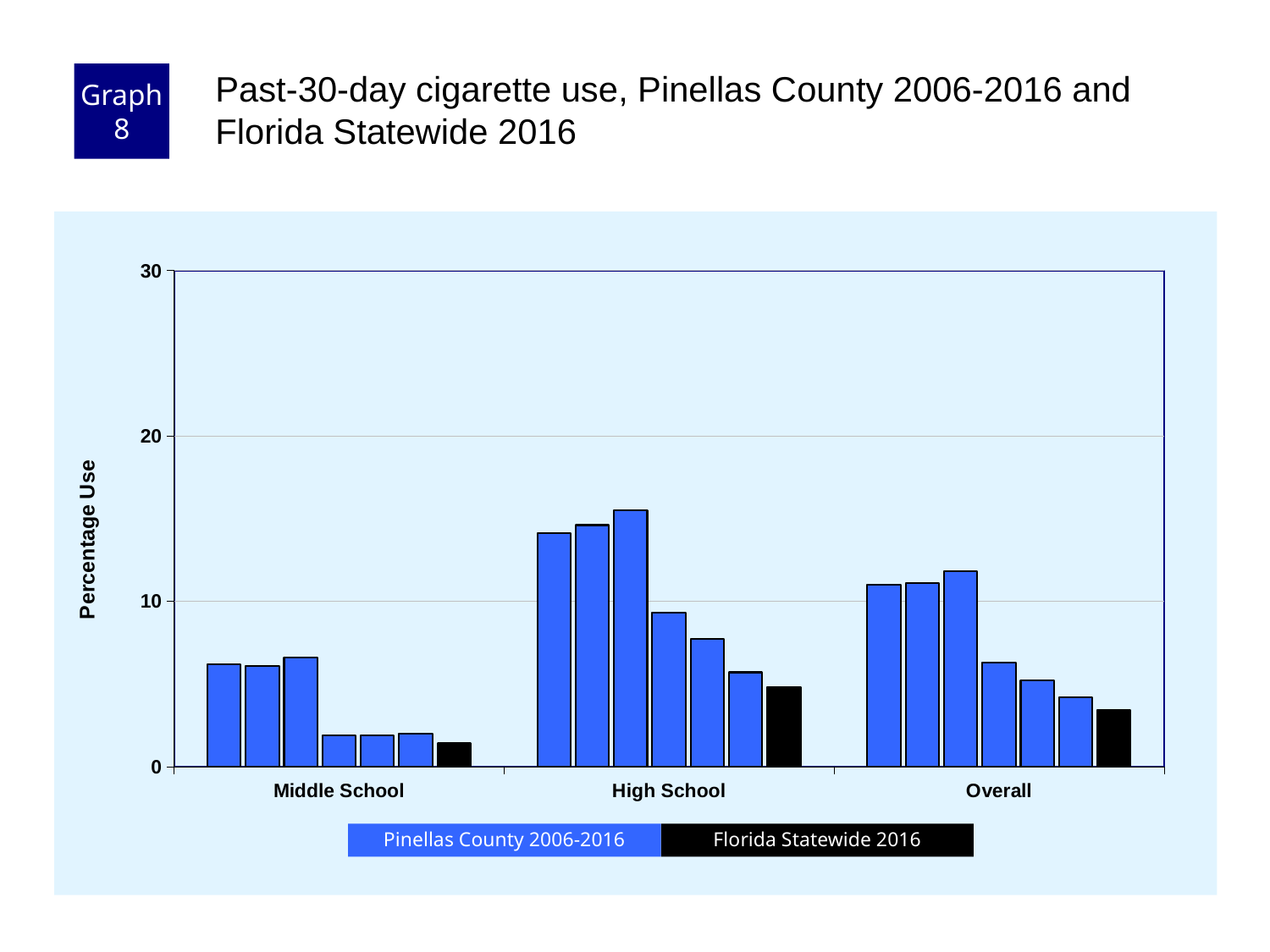
Within the High School group, do the last four Pinellas County bars rise or fall from left to right? fall Is the Florida Statewide 2016 value for Middle School greater or less than 10? less How many series does the legend list? 2 What is the label on the y axis? Percentage Use Which category has the tallest bars? High School Which category has the shortest bars? Middle School What colour are the Florida Statewide 2016 bars? black Is the Florida Statewide 2016 value for High School greater or less than 10? less Is the tallest Pinellas County bar for High School greater or less than 10? greater Which is larger: the Florida Statewide 2016 value for High School or for Middle School? High School What kind of chart is shown on the slide? bar chart How many categories are shown on the x axis? 3